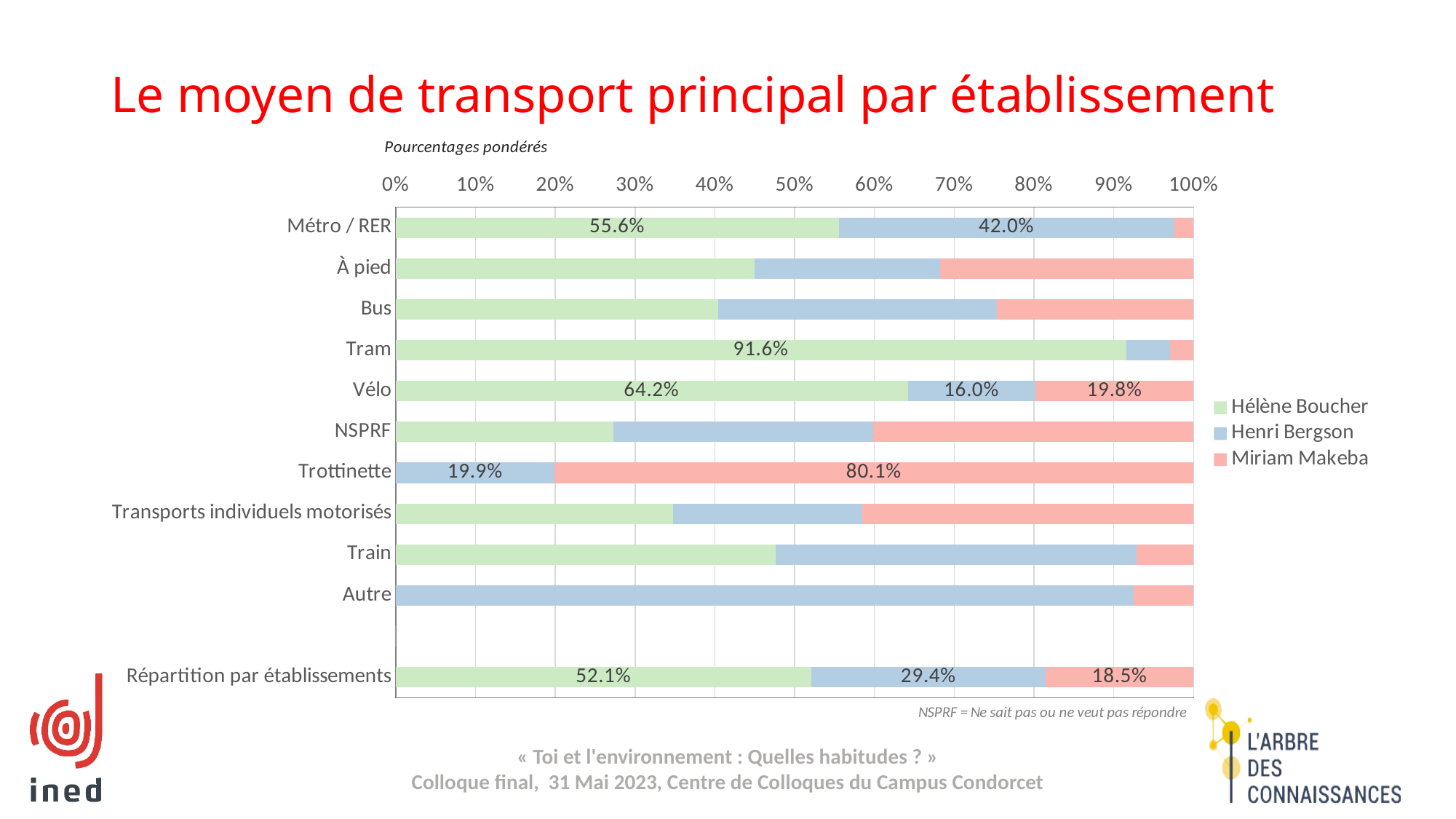
What kind of chart is shown on the slide? Stacked bar chart For Trottinette, which establishment has the larger share: Henri Bergson or Miriam Makeba? Miriam Makeba What is the Hélène Boucher share for Tram? 91.6% Is the Miriam Makeba share for À pied greater or less than 20%? greater What is the Hélène Boucher share for Vélo? 64.2% For Vélo, how many percentage points higher is the Hélène Boucher share than the Miriam Makeba share? 44.4 percentage points What is the Henri Bergson share for Métro / RER? 42.0% What is the Miriam Makeba share for Trottinette? 80.1% How many series does the legend list? 3 What is the Henri Bergson share in the Répartition par établissements bar? 29.4% Is the Hélène Boucher share for Bus greater or less than 50%? less Which transport mode has the highest Hélène Boucher share? Tram